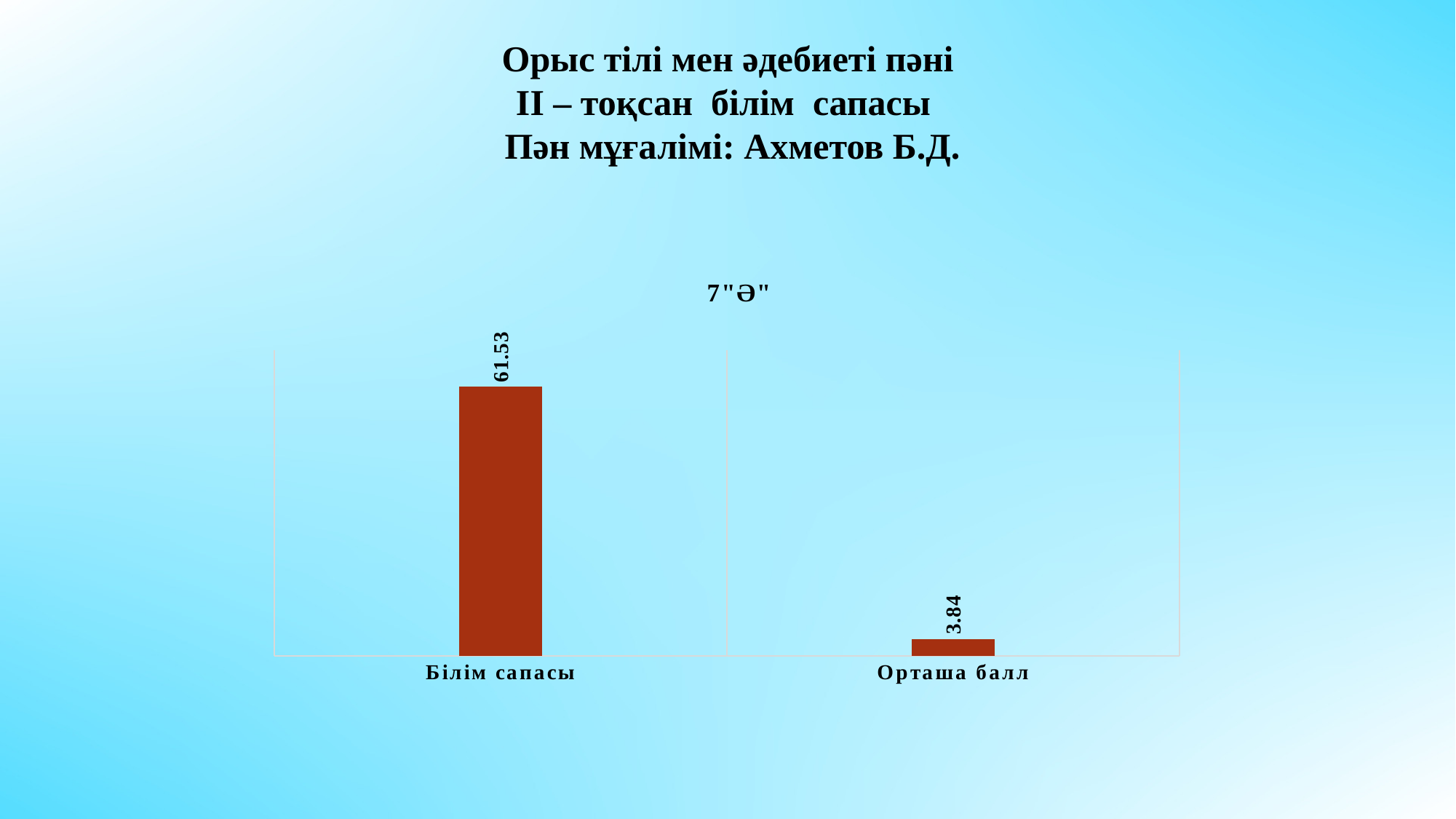
Which category has the lowest value? Орташа балл Which is larger, the value for Білім сапасы or the value for Орташа балл? Білім сапасы What is the value for Білім сапасы? 61.53 What is the value for Орташа балл? 3.84 What is the title of the chart? 7"Ә" How many categories are shown in the chart? 2 What kind of chart is shown on the slide? Bar chart What colour are the bars in the chart? Dark red Do the values rise or fall from left to right along the x axis? Fall Which category has the highest value? Білім сапасы What is the difference between the values for Білім сапасы and Орташа балл? 57.69